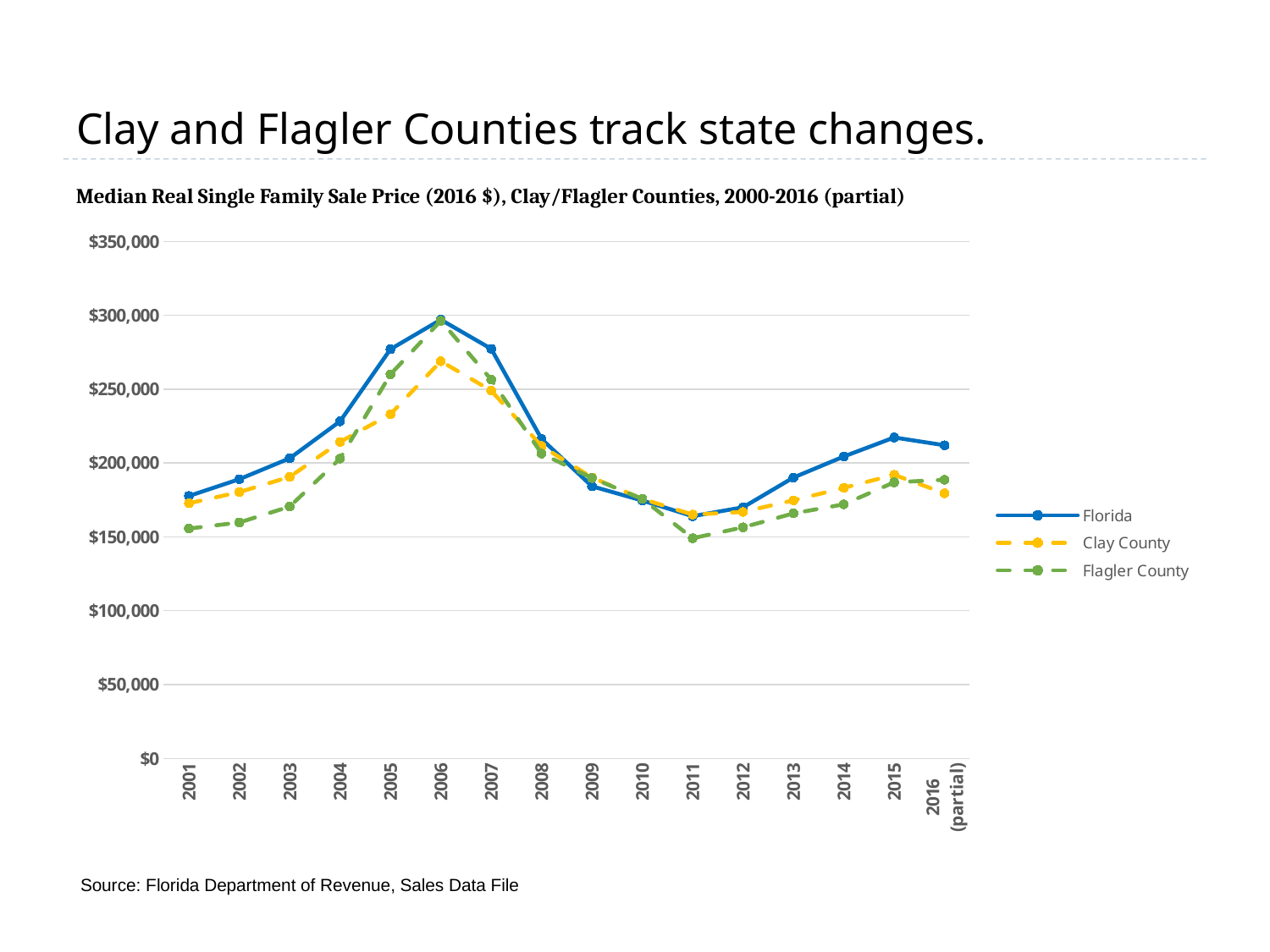
In which year does the Florida series reach its highest value? 2006 Do the Florida values rise or fall from 2006 to 2011? Fall Is the value for Clay County in 2006 greater or less than $250,000? greater In which year does the Flagler County series reach its lowest value? 2011 Which series is drawn with a solid blue line? Florida What kind of chart is shown on the slide? Line chart Is the value for Flagler County in 2001 greater or less than $200,000? less How many years are plotted along the x axis? 16 How many series does the legend list? 3 In 2001, which is higher: Florida or Flagler County? Florida Do the Clay County values rise or fall from 2001 to 2006? Rise Is the value for Florida in 2006 greater or less than $250,000? greater